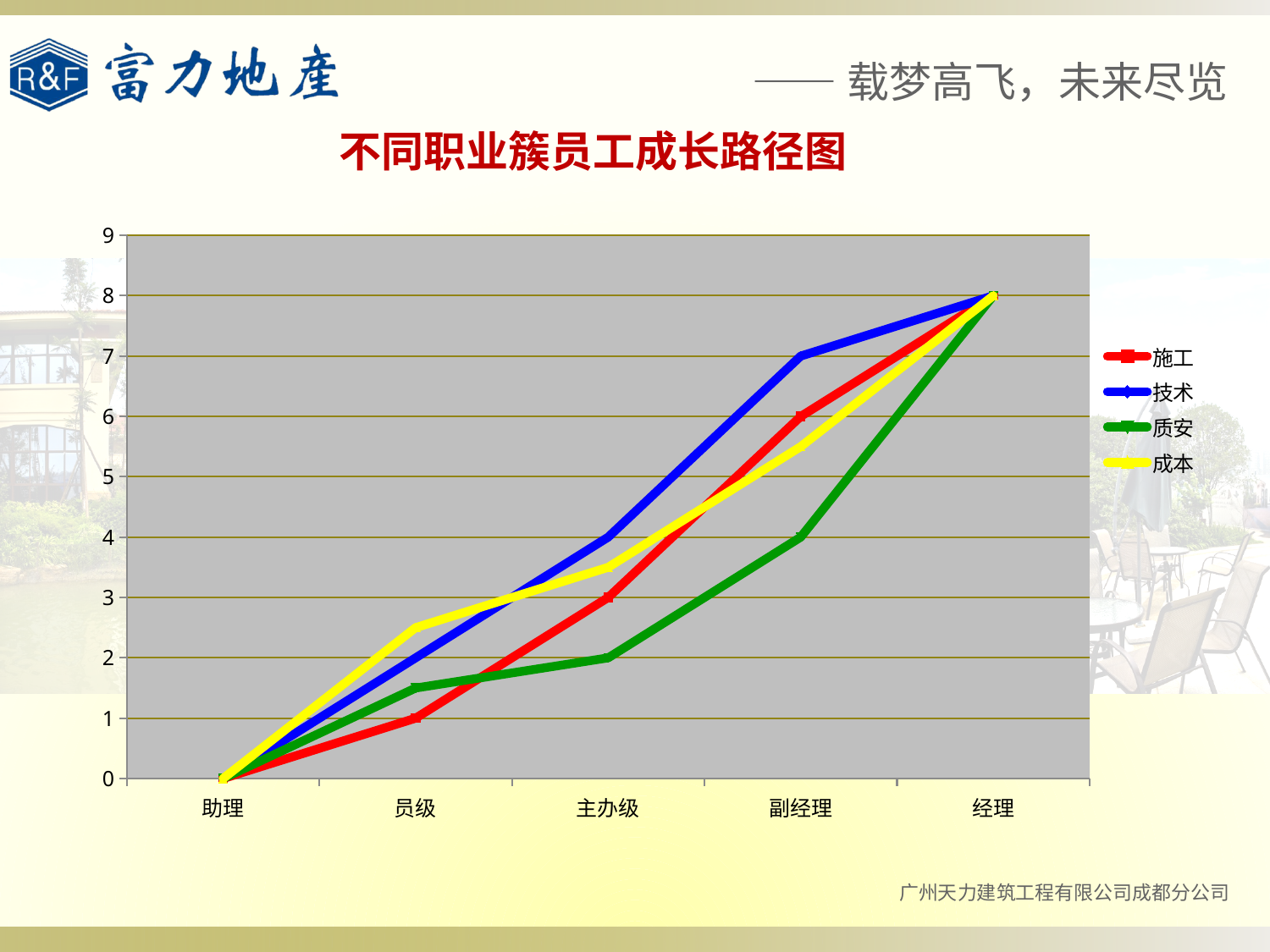
What kind of chart is shown on the slide? line chart What is the value for 技术 at 副经理? 7 What is the difference between 技术 and 施工 at 副经理? 1 Is the value for 成本 at 员级 greater or less than 2? greater What is the value for 施工 at 主办级? 3 What is the value for 质安 at 副经理? 4 Do the values for 施工 rise or fall from 助理 to 经理? rise Which series has the lowest value at 员级? 施工 What is the title of the chart? 不同职业簇员工成长路径图 Which series has the highest value at 副经理? 技术 How many categories are shown on the x axis? 5 How many series does the legend list? 4